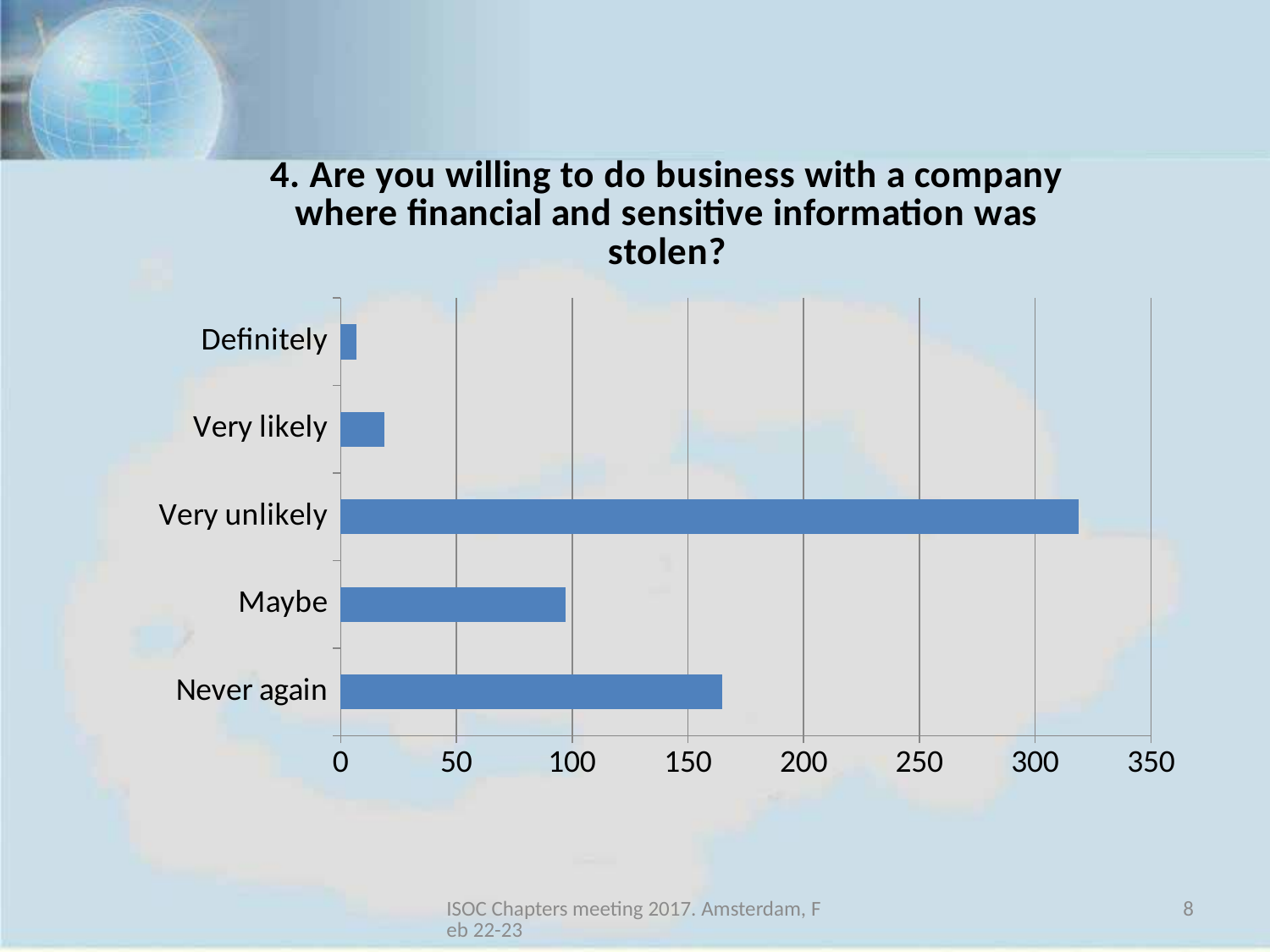
What is the highest value shown on the horizontal axis of the chart? 350 Is the value for Very likely greater or less than 50? less Is the value for Very unlikely greater or less than 300? greater What kind of chart is shown on the slide? bar chart Which is larger, the value for Never again or the value for Maybe? Never again How many response categories are shown in the chart? 5 Which is larger, the value for Very likely or the value for Definitely? Very likely Is the value for Maybe greater or less than 50? greater Which response category has the highest value? Very unlikely Which response category has the lowest value? Definitely